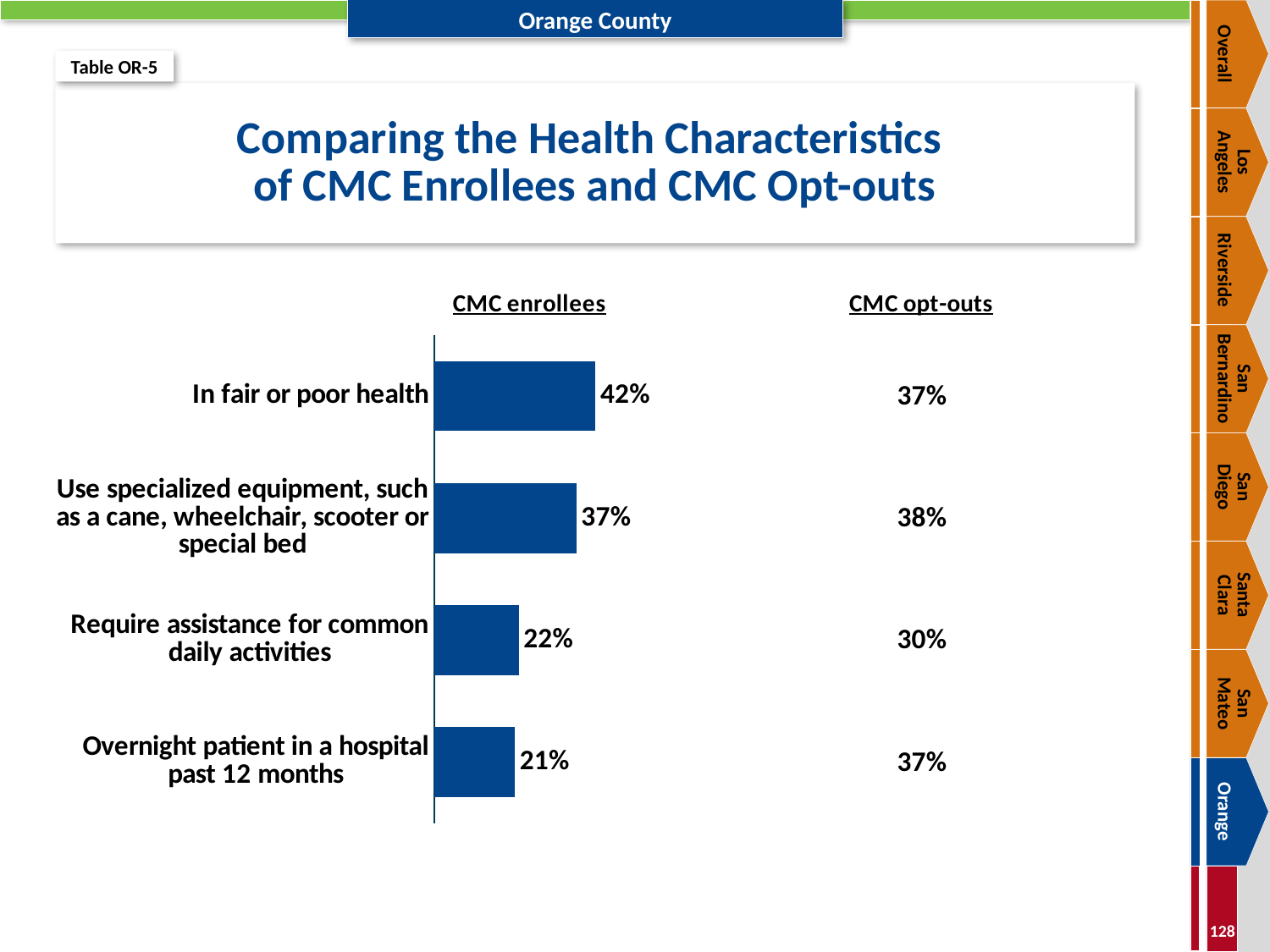
What is the difference in percentage points between CMC opt-outs and CMC enrollees for being an overnight patient in a hospital in the past 12 months? 16 percentage points What is the difference in percentage points between CMC enrollees in fair or poor health and CMC enrollees who require assistance for common daily activities? 20 percentage points What percentage of CMC enrollees use specialized equipment, such as a cane, wheelchair, scooter or special bed? 37% What type of chart is used to show the CMC enrollee percentages? Bar chart Which health characteristic has the lowest percentage among CMC enrollees? Overnight patient in a hospital past 12 months What percentage of CMC enrollees were an overnight patient in a hospital in the past 12 months? 21% What percentage of CMC enrollees require assistance for common daily activities? 22% How many health characteristics are shown as bars in the chart? 4 Which health characteristic has the highest percentage among CMC enrollees? In fair or poor health Among CMC enrollees, which is larger: the share in fair or poor health or the share using specialized equipment? In fair or poor health What percentage of CMC enrollees are in fair or poor health? 42% What is the title of the chart on the slide? Comparing the Health Characteristics of CMC Enrollees and CMC Opt-outs